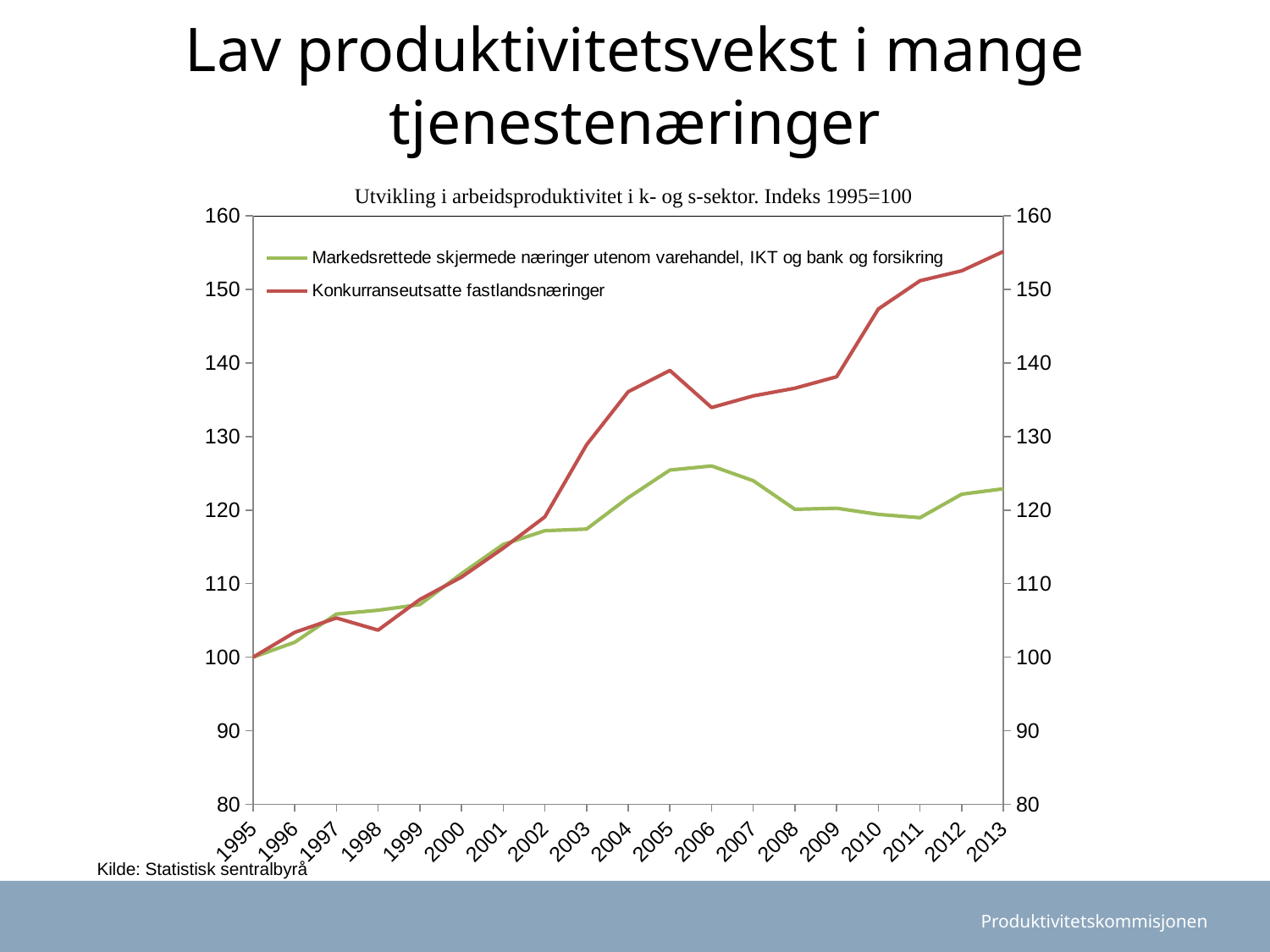
In which year does the Konkurranseutsatte fastlandsnæringer series reach its highest value? 2013 Is the value for Markedsrettede skjermede næringer utenom varehandel, IKT og bank og forsikring in 2013 greater or less than 130? less What is the title of the chart? Utvikling i arbeidsproduktivitet i k- og s-sektor. Indeks 1995=100 What is the value for Konkurranseutsatte fastlandsnæringer in 1995? 100 Is the value for Konkurranseutsatte fastlandsnæringer in 2010 greater or less than 140? greater How many series does the legend list? 2 How many years are shown on the x axis? 19 Does the Konkurranseutsatte fastlandsnæringer series rise or fall from 2009 to 2013? rise What colour is the line for Konkurranseutsatte fastlandsnæringer? red Which series has the higher value in 2013, Konkurranseutsatte fastlandsnæringer or Markedsrettede skjermede næringer utenom varehandel, IKT og bank og forsikring? Konkurranseutsatte fastlandsnæringer What kind of chart is shown on the slide? line chart Is the value for Konkurranseutsatte fastlandsnæringer in 2013 greater or less than 150? greater